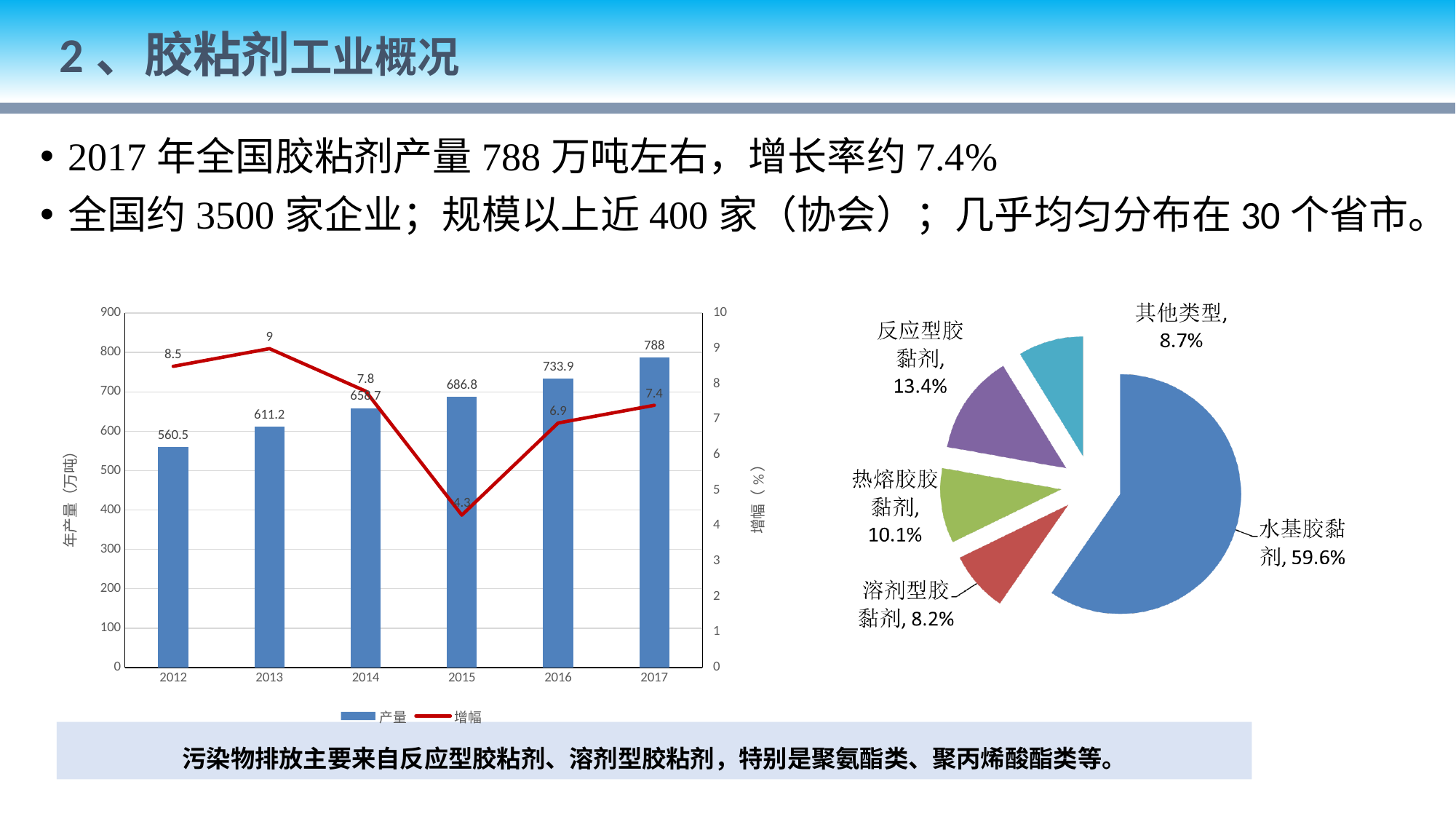
In the pie chart on the right, how many slices are there? 5 In the left chart, how many series does the legend list? 2 In the left chart, is the 增幅 value for 2013 larger or smaller than the 增幅 value for 2016? larger In the left chart, which year has the highest 产量 value? 2017 In the left chart, what is the 增幅 value for 2015? 4.3 In the pie chart on the right, what share does 水基胶黏剂 have? 59.6% In the left chart, what is the difference between the 产量 values for 2017 and 2012? 227.5 In the left chart, do the 产量 bars rise or fall from 2012 to 2017? rise In the left chart, how many years are shown on the x axis? 6 In the pie chart on the right, which category has the smallest share? 溶剂型胶黏剂 In the left chart, what is the 产量 value for 2017? 788 In the left chart, which year has the lowest 增幅 value? 2015